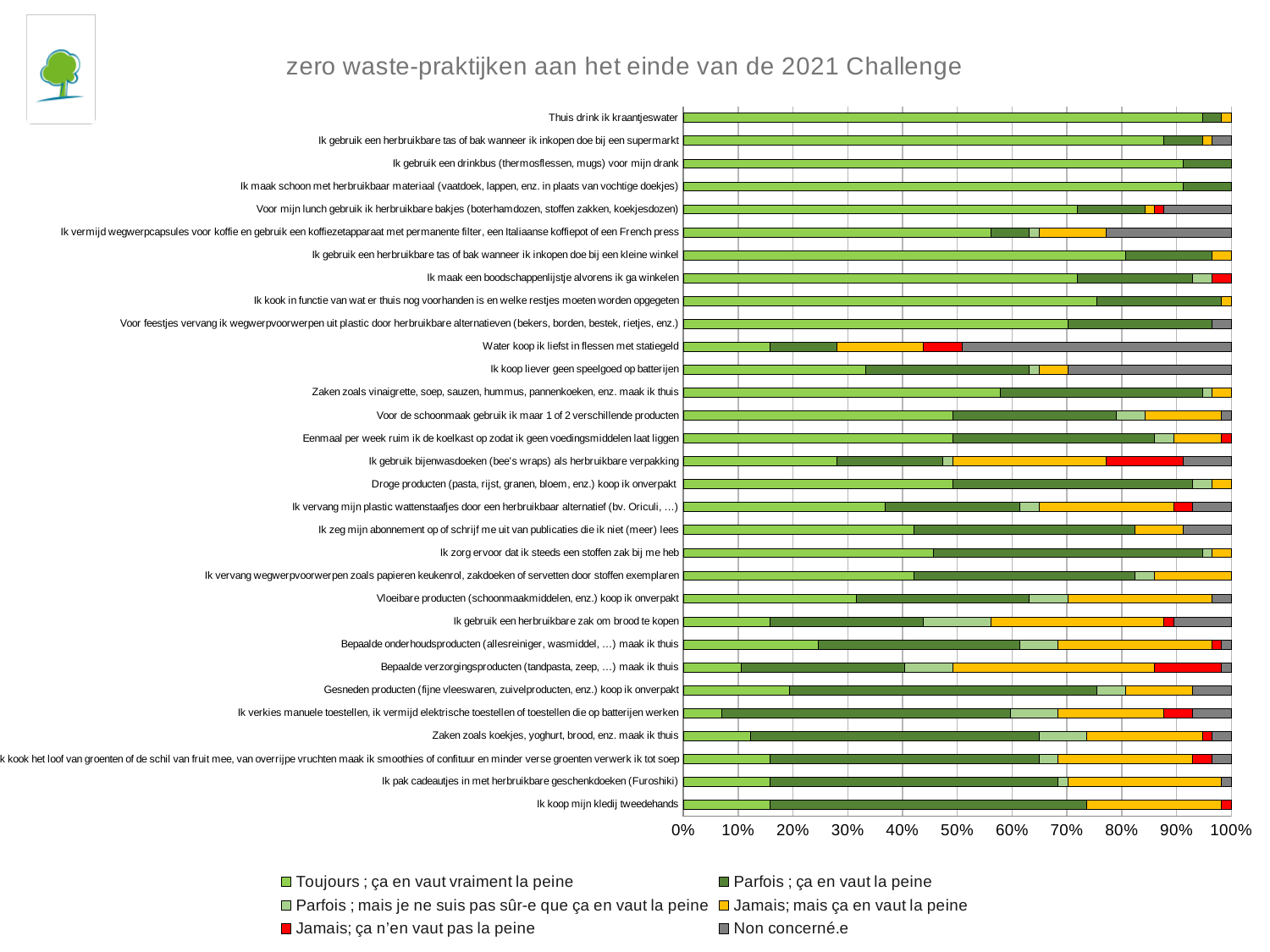
What is the title of the chart? zero waste-praktijken aan het einde van de 2021 Challenge How many series does the legend list? 6 Is the 'Toujours ; ça en vaut vraiment la peine' share for 'Ik koop mijn kledij tweedehands' greater or less than 20%? less How many categories (practices) are plotted on the chart? 31 What kind of chart is shown on the slide? Stacked bar chart Which legend entry is shown in red? Jamais; ça n'en vaut pas la peine Which has the larger 'Toujours ; ça en vaut vraiment la peine' share: 'Ik gebruik een drinkbus (thermosflessen, mugs) voor mijn drank' or 'Ik gebruik bijenwasdoeken (bee's wraps) als herbruikbare verpakking'? Ik gebruik een drinkbus (thermosflessen, mugs) voor mijn drank Is the 'Toujours ; ça en vaut vraiment la peine' share for 'Ik verkies manuele toestellen, ik vermijd elektrische toestellen of toestellen die op batterijen werken' greater or less than 10%? less Which category has the smallest 'Toujours ; ça en vaut vraiment la peine' share? Ik verkies manuele toestellen, ik vermijd elektrische toestellen of toestellen die op batterijen werken Is the 'Toujours ; ça en vaut vraiment la peine' share for 'Water koop ik liefst in flessen met statiegeld' greater or less than 20%? less Which has the larger 'Toujours ; ça en vaut vraiment la peine' share: 'Thuis drink ik kraantjeswater' or 'Ik koop mijn kledij tweedehands'? Thuis drink ik kraantjeswater